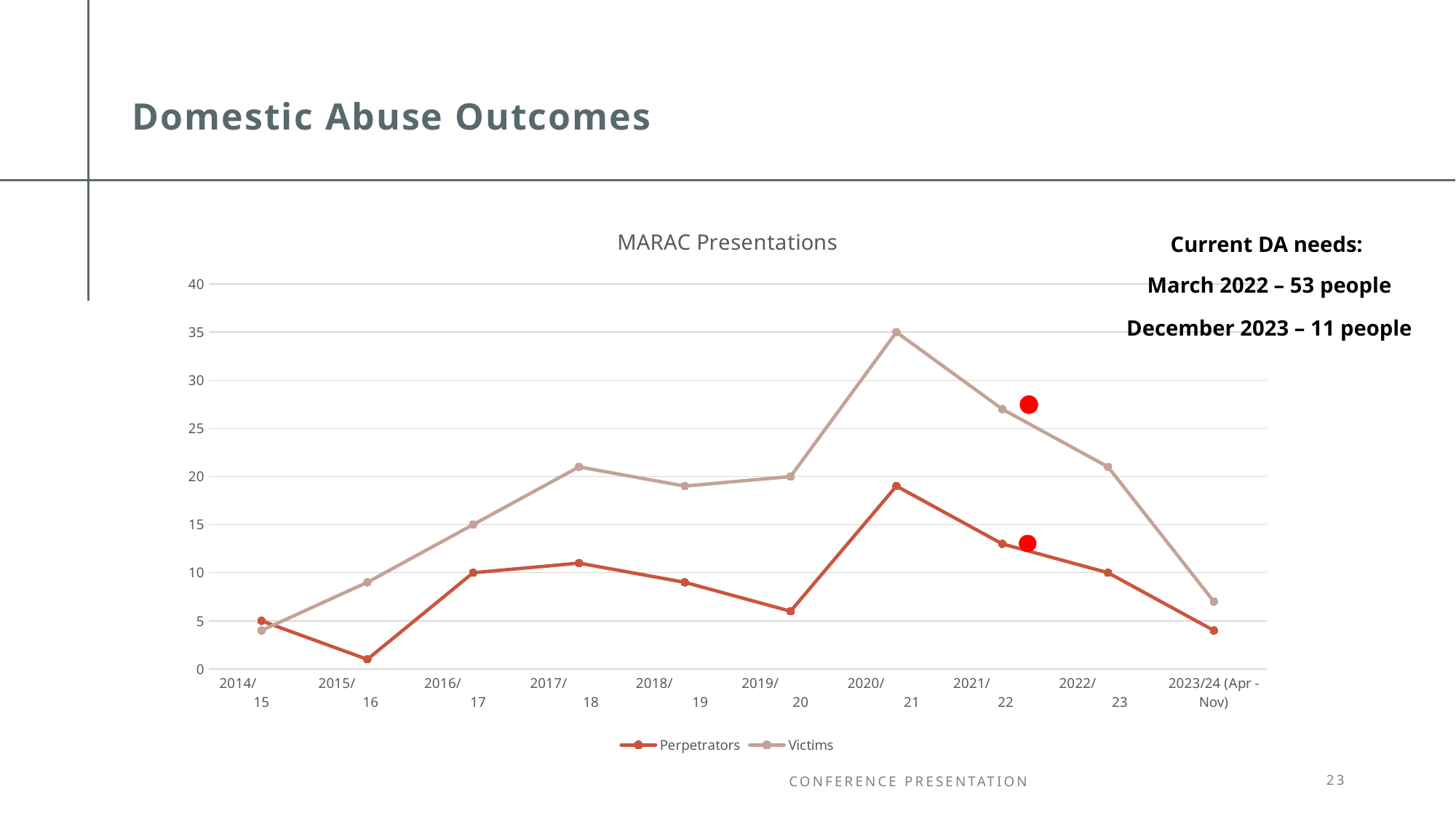
What is the title of the chart? MARAC Presentations What kind of chart is shown on the slide? line chart How many series does the legend list? 2 Is the Victims value for 2021/22 greater or less than 25? greater What is the Victims value for 2019/20? 20 In which period is the Victims series highest? 2020/21 In which period is the Perpetrators series lowest? 2015/16 What is the Victims value for 2020/21? 35 How many time periods are shown along the x axis? 10 Does the Victims series rise or fall from 2020/21 to 2023/24 (Apr - Nov)? fall What is the Perpetrators value for 2016/17? 10 Is the Perpetrators value for 2015/16 greater or less than 5? less